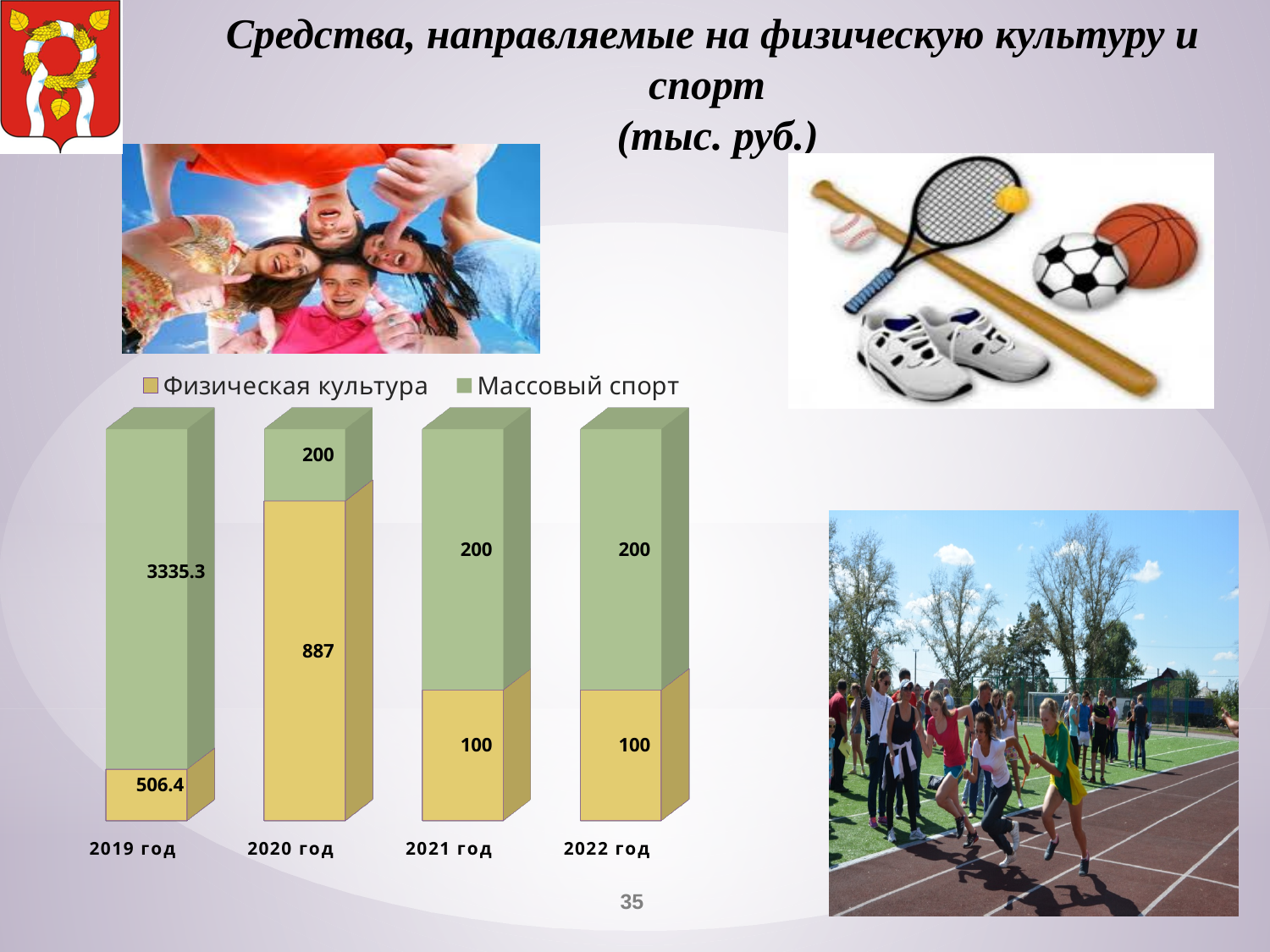
What is the difference between Массовый спорт and Физическая культура in 2019 год? 2828.9 What is the total of the stacked bar for 2020 год? 1087 What is the value for Физическая культура in 2021 год? 100 How many years are shown on the x axis of the chart? 4 What is the value for Массовый спорт in 2022 год? 200 What is the value for Массовый спорт in 2019 год? 3335.3 What is the value for Физическая культура in 2020 год? 887 What is the total of the stacked bar for 2021 год? 300 In which year is the value for Физическая культура highest? 2020 год How many series does the chart legend list? 2 In which year is the value for Массовый спорт highest? 2019 год Which is larger in 2020 год: Физическая культура or Массовый спорт? Физическая культура